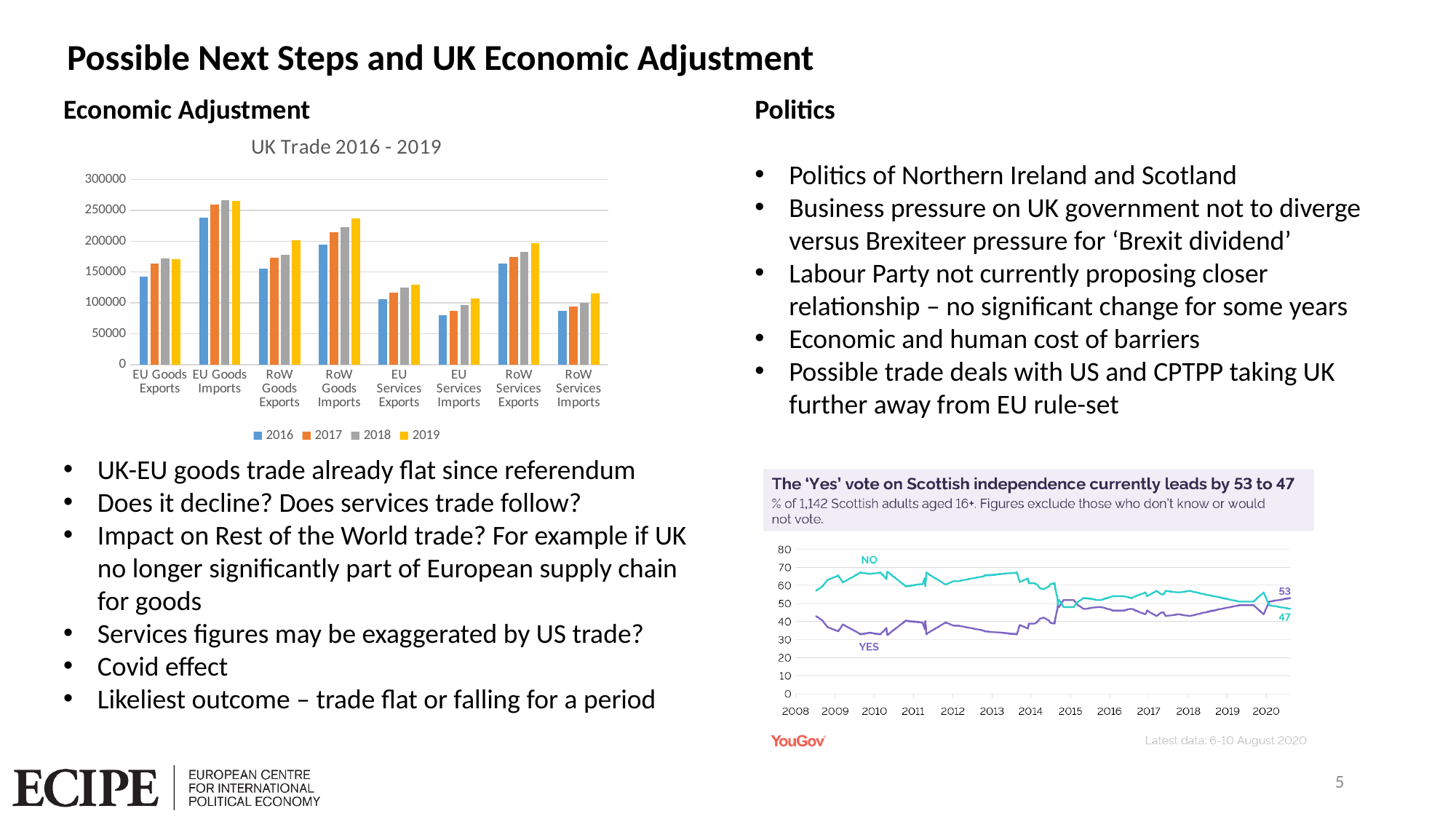
In the 'UK Trade 2016 - 2019' chart, which is larger in 2019: EU Goods Imports or EU Goods Exports? EU Goods Imports In the 'UK Trade 2016 - 2019' chart, which category has the highest bars? EU Goods Imports In the Scottish independence chart on the right, what is the latest value for the 'Yes' line? 53 How many trade categories are shown on the x axis of the 'UK Trade 2016 - 2019' chart? 8 In the 'UK Trade 2016 - 2019' chart, is the 2019 value for EU Goods Imports greater or less than 250000? greater In the 'UK Trade 2016 - 2019' chart, do the RoW Goods Imports bars rise or fall from 2016 to 2019? Rise What kind of chart is the 'UK Trade 2016 - 2019' chart? Bar chart In the 'UK Trade 2016 - 2019' chart, is the 2016 value for EU Services Exports greater or less than 150000? less What are the legend entries of the 'UK Trade 2016 - 2019' chart? 2016, 2017, 2018, 2019 How many series does the legend of the 'UK Trade 2016 - 2019' chart list? 4 In the Scottish independence chart on the right, by how many points does the latest 'Yes' value exceed the latest 'No' value? 6 In the Scottish independence chart on the right, what is the latest value for the 'No' line? 47